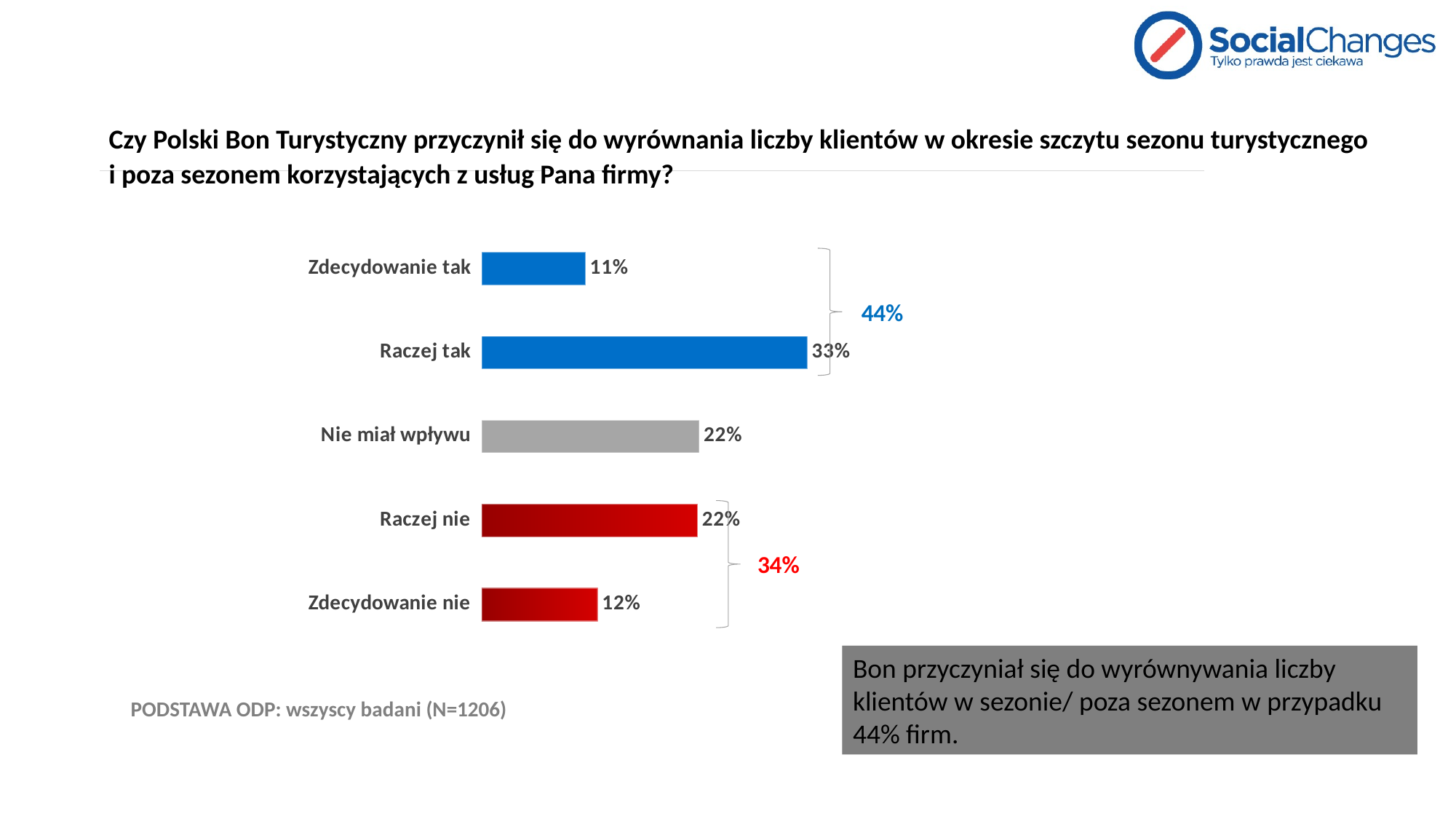
What is the difference between "Raczej tak" and "Raczej nie"? 11% Which category has the lowest value? Zdecydowanie tak What is the value for "Raczej tak"? 33% What is the value for "Zdecydowanie tak"? 11% What combined percentage is shown by the bracket grouping "Zdecydowanie tak" and "Raczej tak"? 44% Which category has the highest value? Raczej tak What is the value for "Zdecydowanie nie"? 12% What combined percentage is shown by the bracket grouping "Raczej nie" and "Zdecydowanie nie"? 34% Which is larger, "Zdecydowanie nie" or "Zdecydowanie tak"? Zdecydowanie nie What is the value for "Nie miał wpływu"? 22% What kind of chart is shown on the slide? Bar chart How many categories are shown in the chart? 5